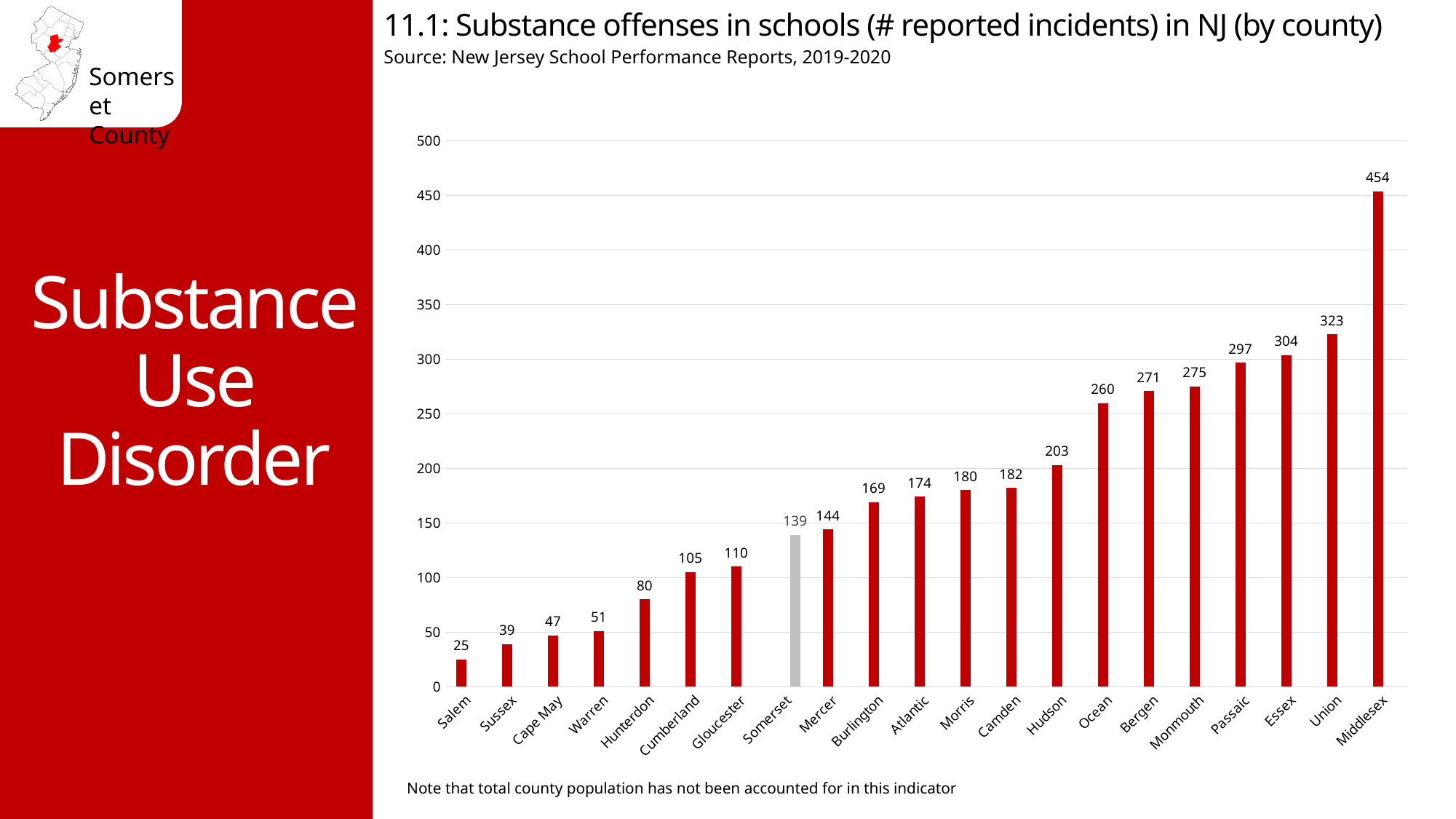
What is the difference between the values for Middlesex and Somerset? 315 How many counties are shown on the x axis of the chart? 21 What is the value shown for Middlesex County? 454 Which county's bar is coloured grey instead of red? Somerset Which county has the lowest number of reported incidents? Salem What is the difference between the values for Union and Essex? 19 What kind of chart is shown on the slide? Bar chart Is the value for Hudson greater or less than 200? greater Which county has the highest number of reported incidents? Middlesex Which county has a larger value, Mercer or Somerset? Mercer What is the value shown for Hunterdon County? 80 What is the number of reported substance offense incidents in schools for Somerset County? 139